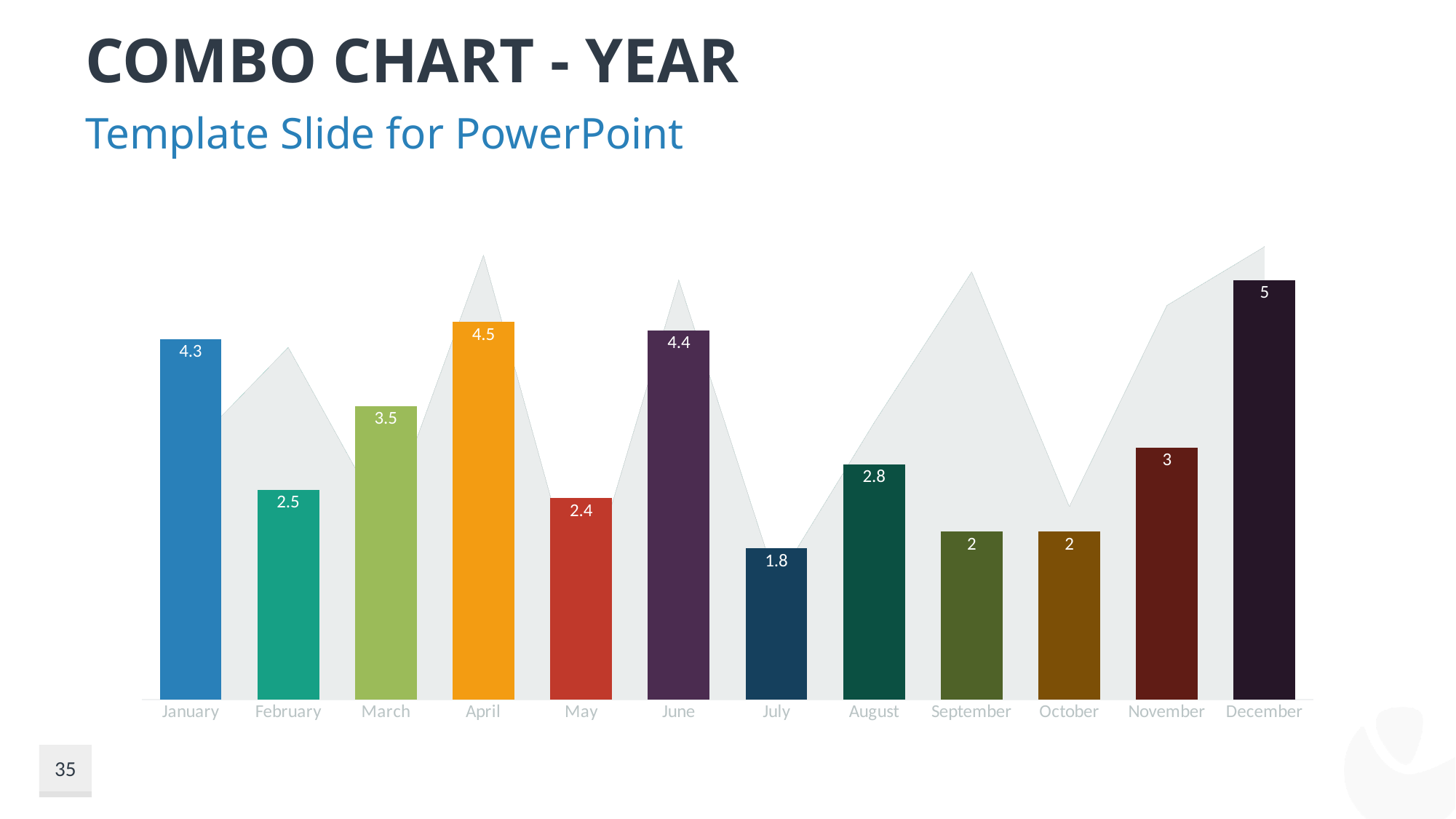
Which is larger, the value for March or the value for August? March What is the difference between the values for January and February? 1.8 How many months are shown on the x axis? 12 What kind of chart is shown on the slide? Combo chart (bar chart with an area series) What is the value for July? 1.8 What is the value for April? 4.5 Which month has the highest bar value? December What is the difference between the values for December and July? 3.2 Do the bar values rise or fall from September to December? Rise What is the title of the slide? COMBO CHART - YEAR Which month has the lowest bar value? July What is the value for November? 3